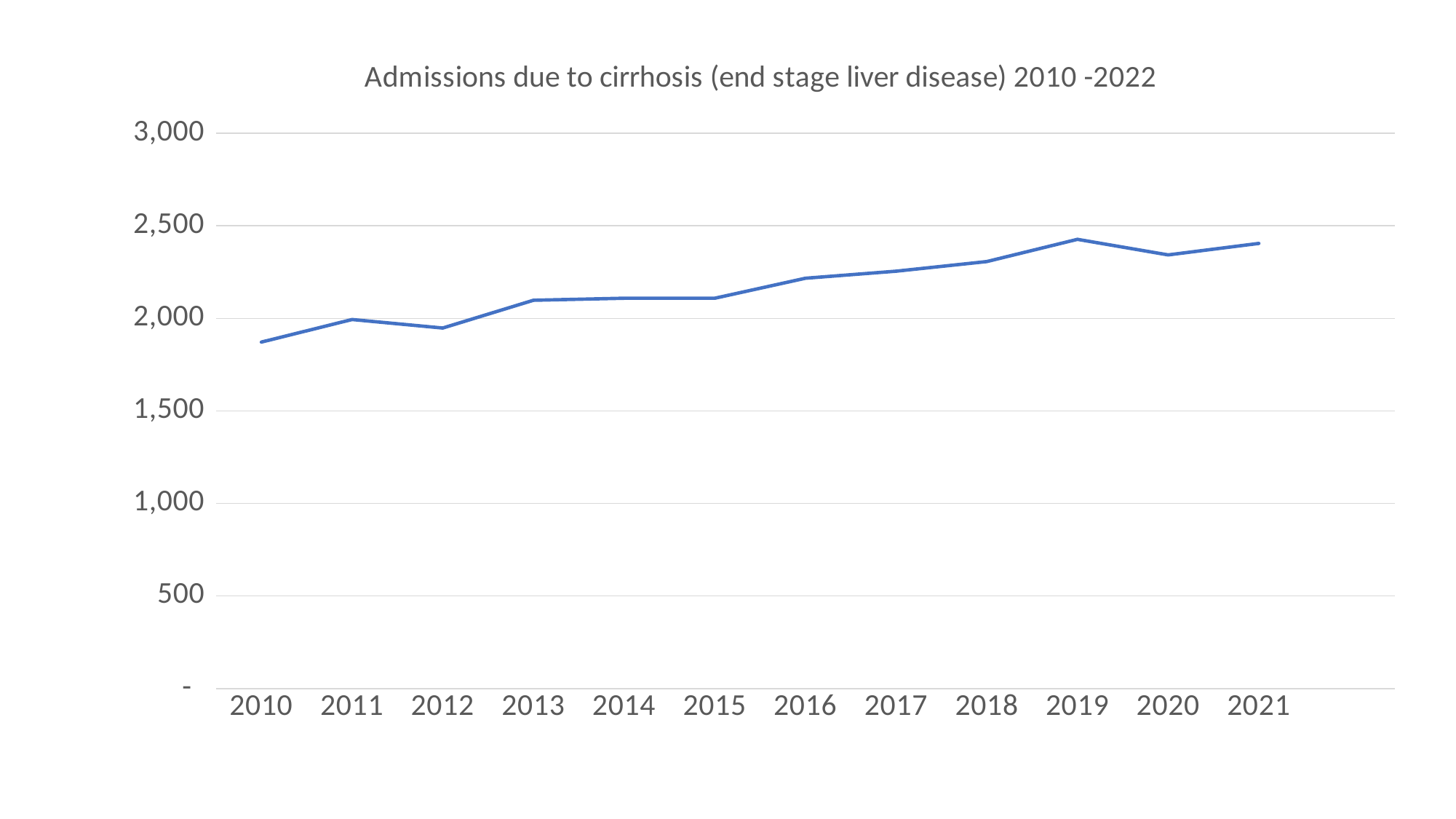
Is the value for 2012 greater or less than 2,000? less How many years are plotted along the x axis? 12 What is the title of the chart? Admissions due to cirrhosis (end stage liver disease) 2010 -2022 Is the value for 2010 greater or less than 2,000? less Is the value for 2016 greater or less than 2,000? greater What kind of chart is shown on the slide? line chart Which year has more admissions, 2019 or 2020? 2019 Which year has more admissions, 2010 or 2021? 2021 Which year has the lowest number of admissions? 2010 Do admissions generally rise or fall from 2010 to 2021? rise Which year has the highest number of admissions? 2019